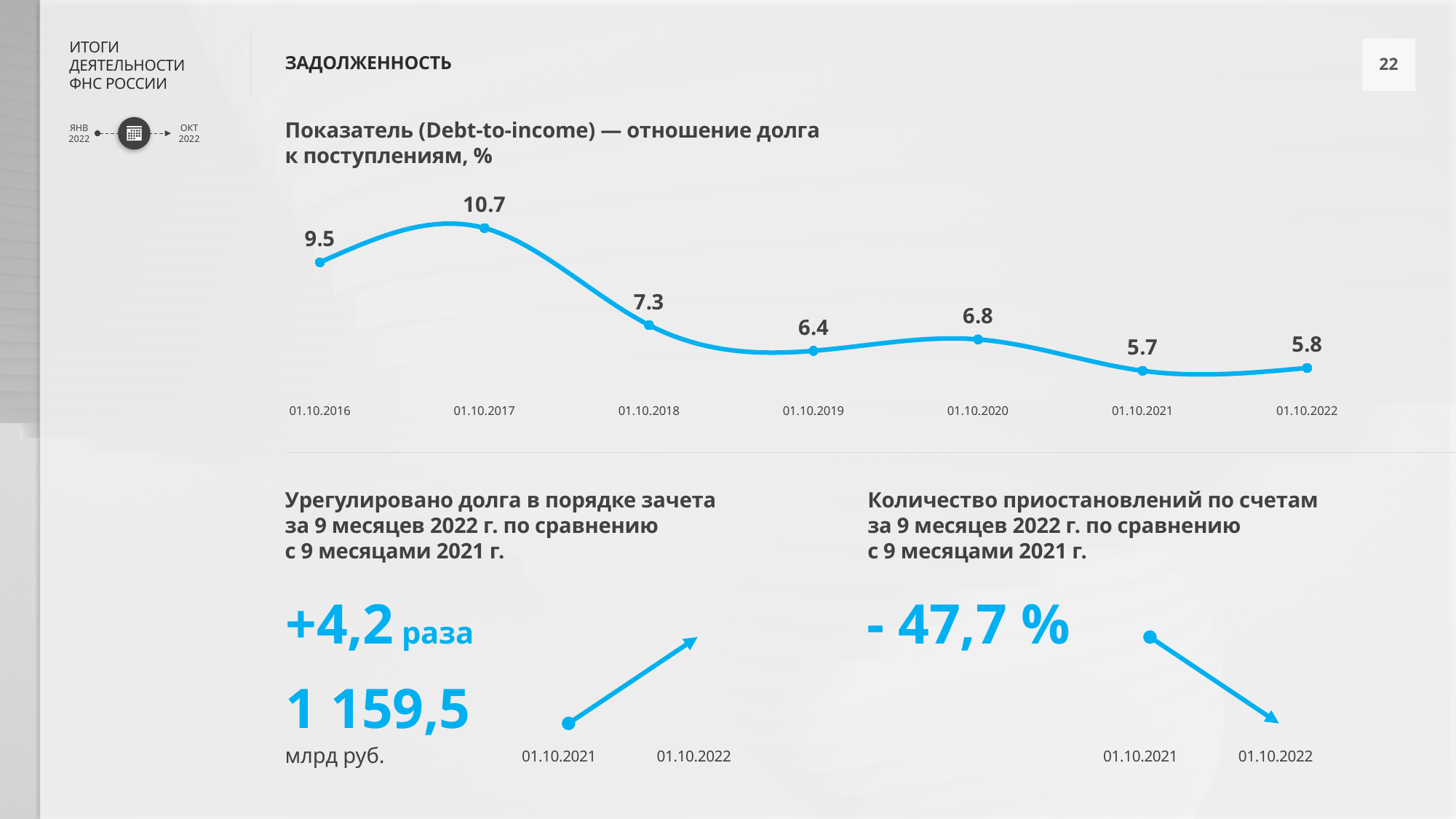
What is the difference between the values for 01.10.2017 and 01.10.2016? 1.2 What is the title of the line chart? Показатель (Debt-to-income) — отношение долга к поступлениям, % What is the Debt-to-income value for 01.10.2022? 5.8 Which is larger, the value for 01.10.2020 or for 01.10.2019? 01.10.2020 How many data points are plotted on the line chart? 7 What is the Debt-to-income value for 01.10.2019? 6.4 What type of chart is shown on the slide? line chart What is the Debt-to-income value for 01.10.2017? 10.7 Which date has the highest Debt-to-income value? 01.10.2017 Does the Debt-to-income value generally rise or fall from 01.10.2017 to 01.10.2022? fall Which date has the lowest Debt-to-income value? 01.10.2021 What is the difference between the values for 01.10.2016 and 01.10.2022? 3.7